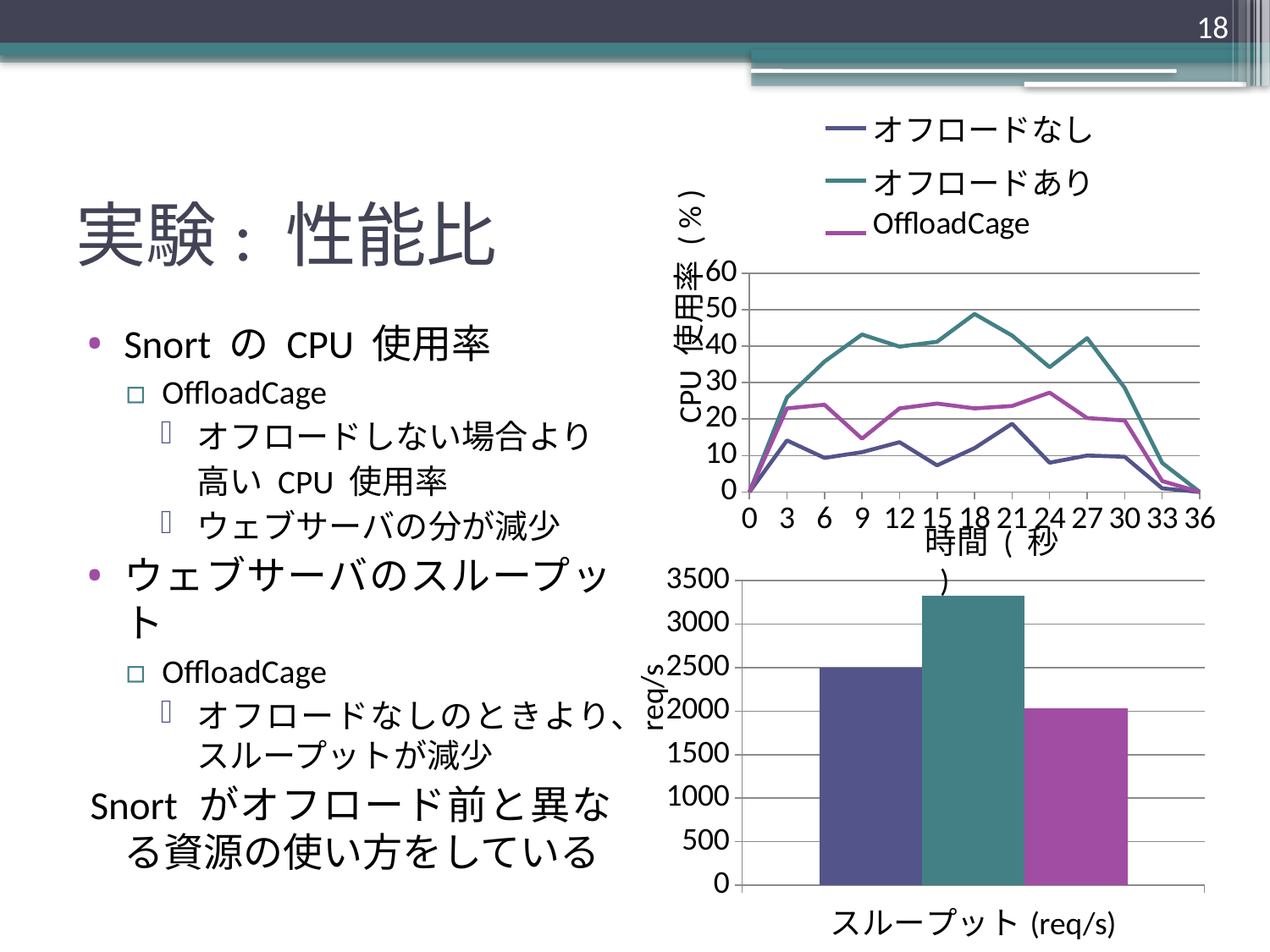
In the lower bar chart, how many bars are plotted? 3 In the upper line chart, is the value for オフロードあり at time 18 greater or less than 40? greater In the upper line chart, which series has the lowest CPU 使用率 over most of the time range? オフロードなし In the upper line chart, how many time points are labelled on the x axis? 13 In the upper line chart, is the value for オフロードなし at time 18 greater or less than 30? less What kind of chart is the lower chart on the slide (スループット (req/s))? bar chart In the lower bar chart, is the value of the middle (teal) bar greater or less than 3000? greater How many series does the legend of the upper line chart list? 3 In the upper line chart, at time 24, which is larger: OffloadCage or オフロードなし? OffloadCage In the upper line chart, which series reaches the highest CPU 使用率? オフロードあり In the lower bar chart, which bar is the lowest? the right (magenta) bar What kind of chart is the upper chart on the slide (CPU 使用率 over 時間)? line chart